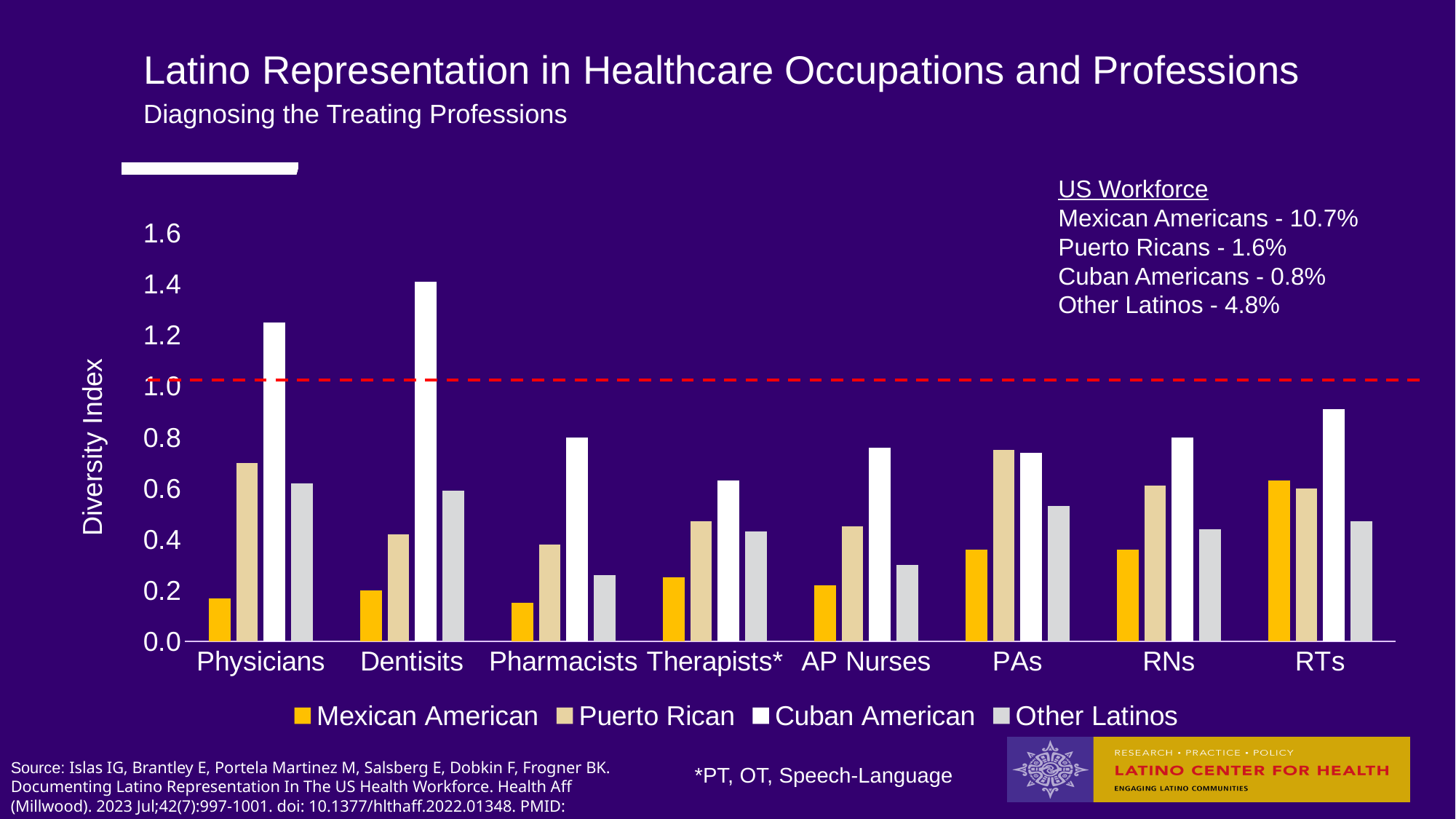
Which is larger, the Cuban American value for Dentisits or for Physicians? Dentisits How many occupations have a Cuban American value above 1.0? 2 Which is larger for Physicians, the Puerto Rican value or the Other Latinos value? Puerto Rican What kind of chart is shown on the slide? bar chart Which occupation has the highest Mexican American diversity index? RTs Which occupation has the highest Cuban American diversity index? Dentisits What is the label on the y axis? Diversity Index How many series does the legend list? 4 Is the Other Latinos value for Pharmacists greater or less than 0.4? less How many occupation categories are shown on the x axis? 8 Is the Cuban American value for Physicians greater or less than 1.0? greater